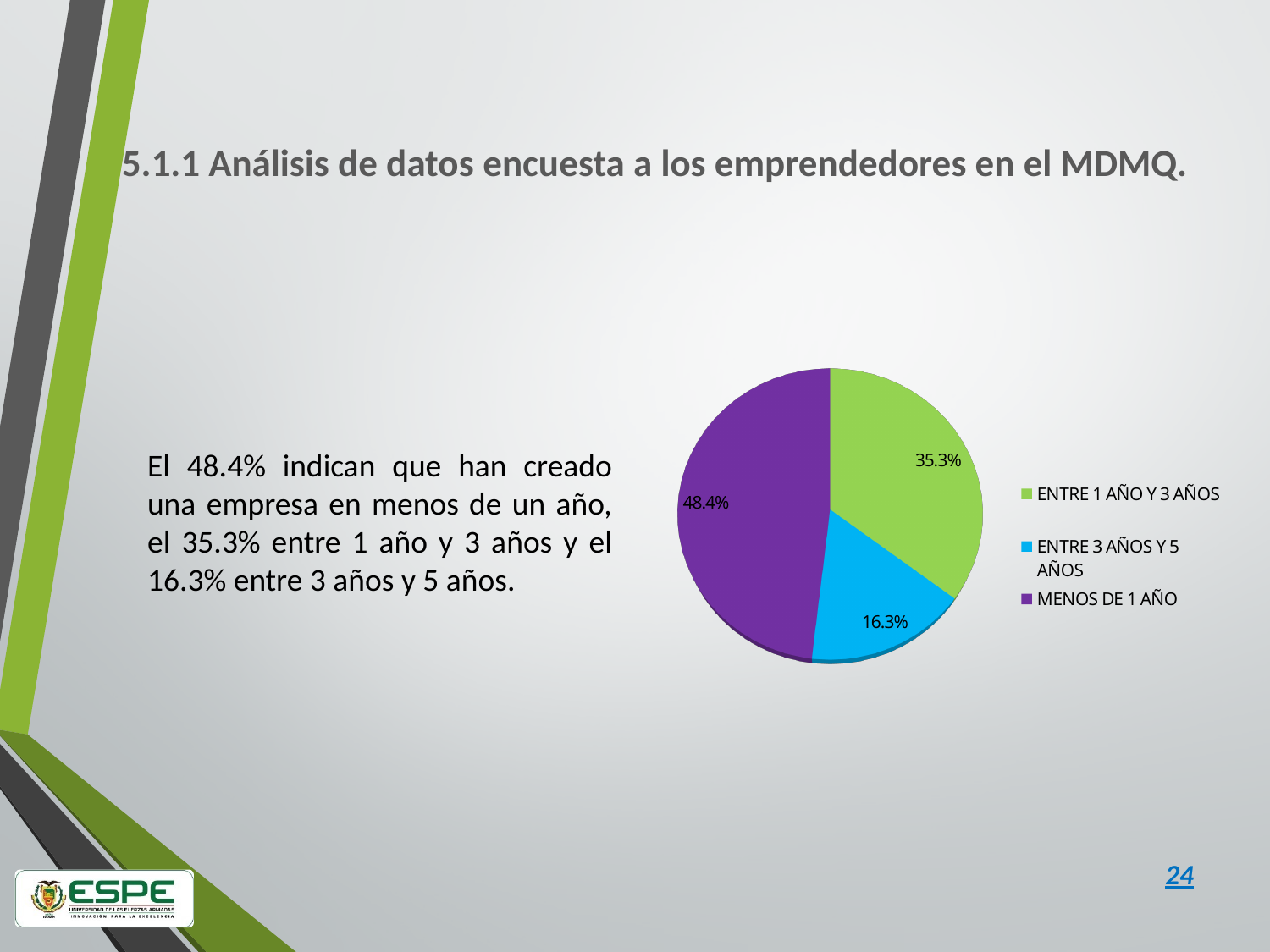
Which category has the largest slice of the pie? MENOS DE 1 AÑO How many slices does the pie chart have? 3 What kind of chart is shown on the slide? pie chart How many entries does the legend list? 3 Which category has the smallest slice of the pie? ENTRE 3 AÑOS Y 5 AÑOS What share of the pie does ENTRE 1 AÑO Y 3 AÑOS represent? 35.3% Which is larger, the slice for ENTRE 1 AÑO Y 3 AÑOS or the slice for ENTRE 3 AÑOS Y 5 AÑOS? ENTRE 1 AÑO Y 3 AÑOS What is the difference in percentage points between ENTRE 1 AÑO Y 3 AÑOS and ENTRE 3 AÑOS Y 5 AÑOS? 19 What share of the pie does MENOS DE 1 AÑO represent? 48.4% What colour is the slice for MENOS DE 1 AÑO? purple What is the difference in percentage points between MENOS DE 1 AÑO and ENTRE 1 AÑO Y 3 AÑOS? 13.1 What share of the pie does ENTRE 3 AÑOS Y 5 AÑOS represent? 16.3%